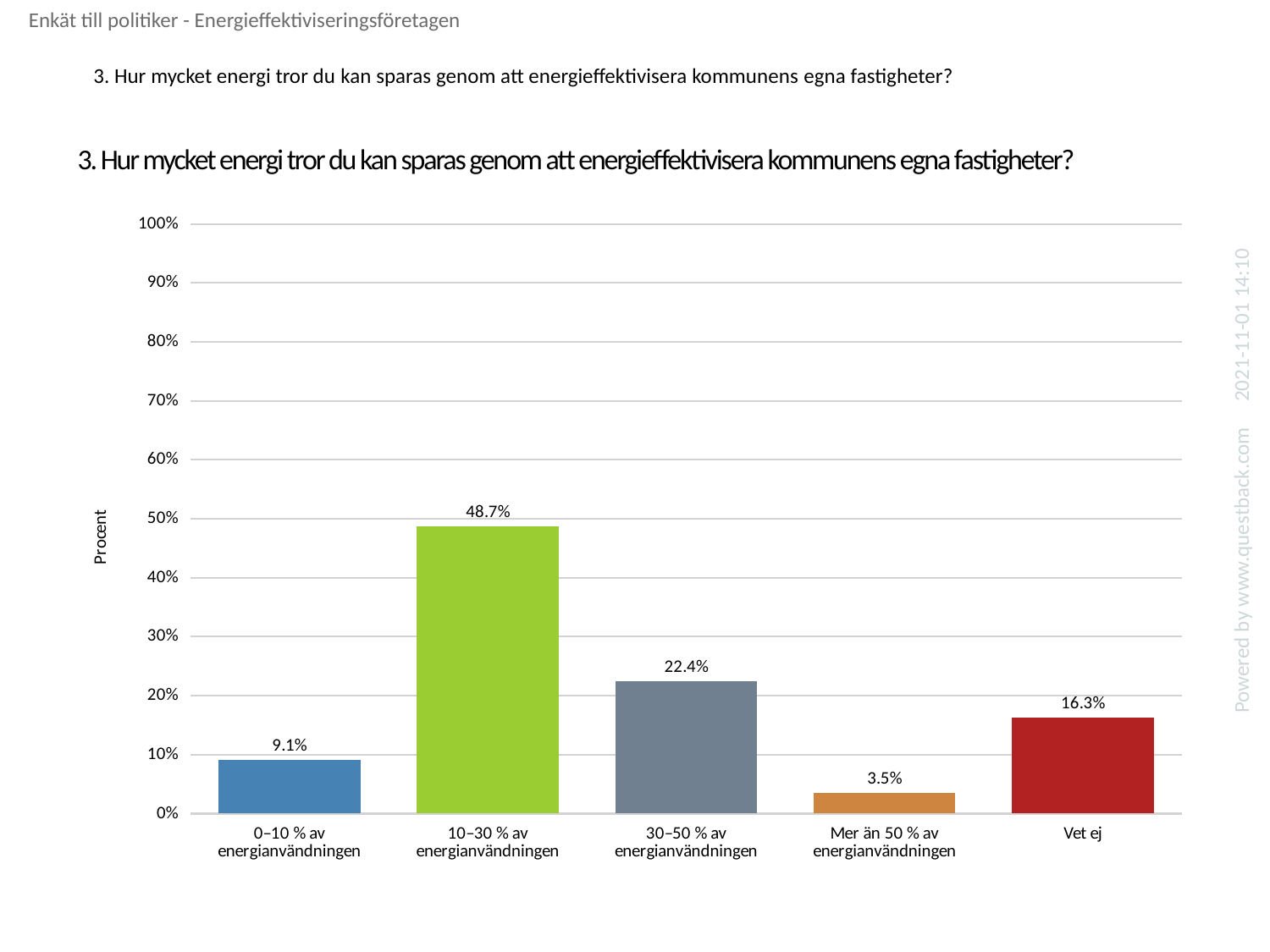
Which category has the highest value? 10–30 % av energianvändningen What is the label of the y axis? Procent What is the value for '10–30 % av energianvändningen'? 48.7% Is the value for '30–50 % av energianvändningen' greater or less than 20%? greater What kind of chart is shown on the slide? bar chart What is the difference between the values for '10–30 % av energianvändningen' and '30–50 % av energianvändningen'? 26.3% How many categories are shown on the x axis? 5 What colour is the bar for '10–30 % av energianvändningen'? green Which category has the lowest value? Mer än 50 % av energianvändningen What is the value for 'Mer än 50 % av energianvändningen'? 3.5% Which is larger: the value for '0–10 % av energianvändningen' or the value for 'Vet ej'? Vet ej What is the value for 'Vet ej'? 16.3%